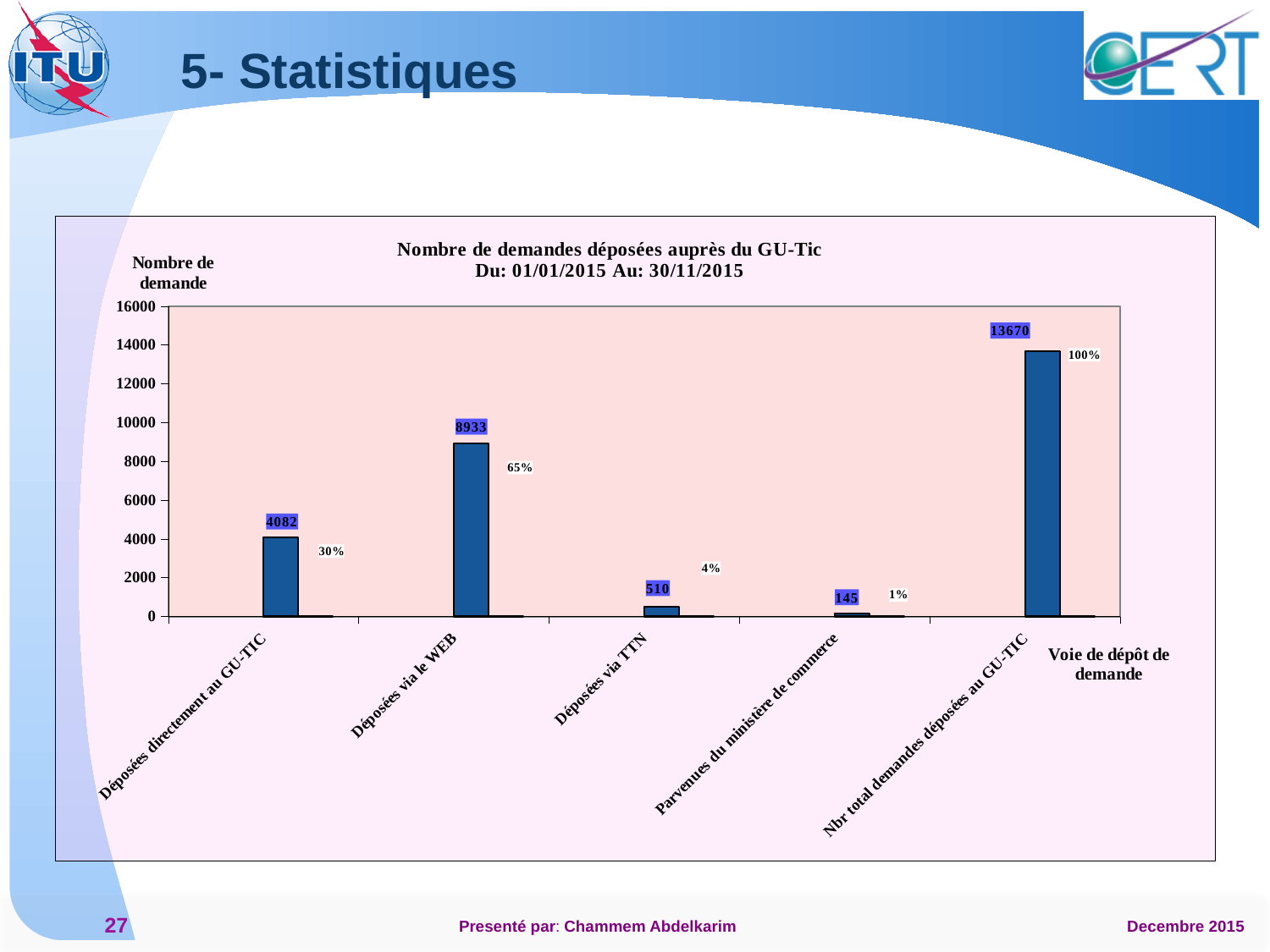
What is the title of the chart? Nombre de demandes déposées auprès du GU-Tic Du: 01/01/2015 Au: 30/11/2015 What is the value for "Déposées via le WEB"? 8933 Which category has the highest value? Nbr total demandes déposées au GU-TIC What is the value for "Déposées directement au GU-TIC"? 4082 Which is larger, the value for "Déposées via TTN" or the value for "Parvenues du ministère de commerce"? Déposées via TTN What is the value for "Parvenues du ministère de commerce"? 145 What is the difference between the values for "Déposées via le WEB" and "Déposées directement au GU-TIC"? 4851 Which category has the lowest value? Parvenues du ministère de commerce Is the value for "Nbr total demandes déposées au GU-TIC" greater or less than 12000? greater How many categories are shown on the x axis? 5 What percentage is shown next to the bar for "Déposées via TTN"? 4% What kind of chart is shown on the slide? bar chart